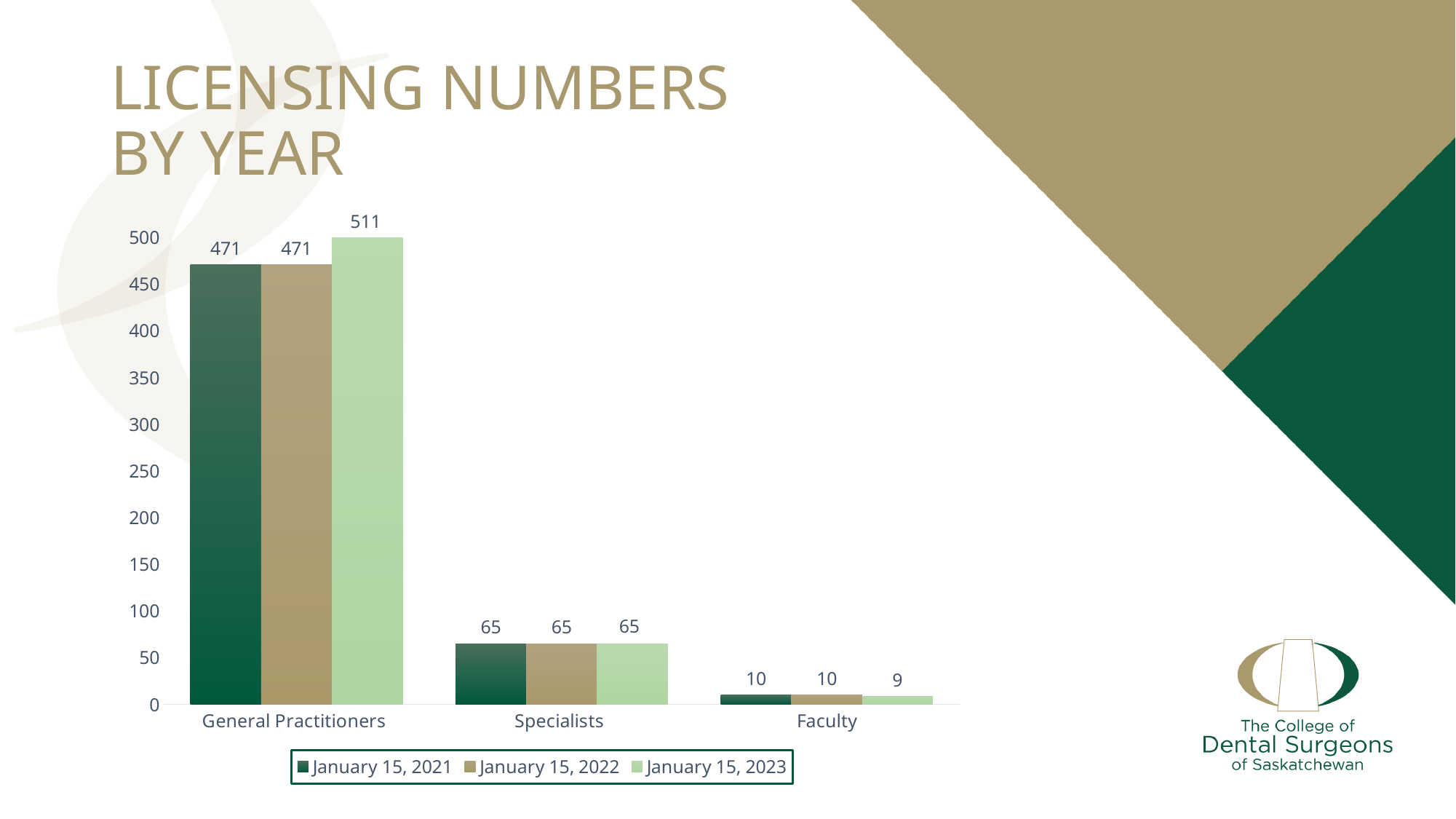
Which category has the highest value on January 15, 2023? General Practitioners What is the value for General Practitioners on January 15, 2022? 471 What is the value for Faculty on January 15, 2023? 9 What kind of chart is shown on the slide? Bar chart How many categories are shown on the x axis? 3 What is the title of the slide? LICENSING NUMBERS BY YEAR How many series does the legend list? 3 Which category has the lowest value on January 15, 2021? Faculty What is the difference between the General Practitioners values for January 15, 2023 and January 15, 2022? 40 What is the value for General Practitioners on January 15, 2023? 511 What is the value for Specialists on January 15, 2021? 65 Which is larger: the Faculty value for January 15, 2022 or for January 15, 2023? January 15, 2022